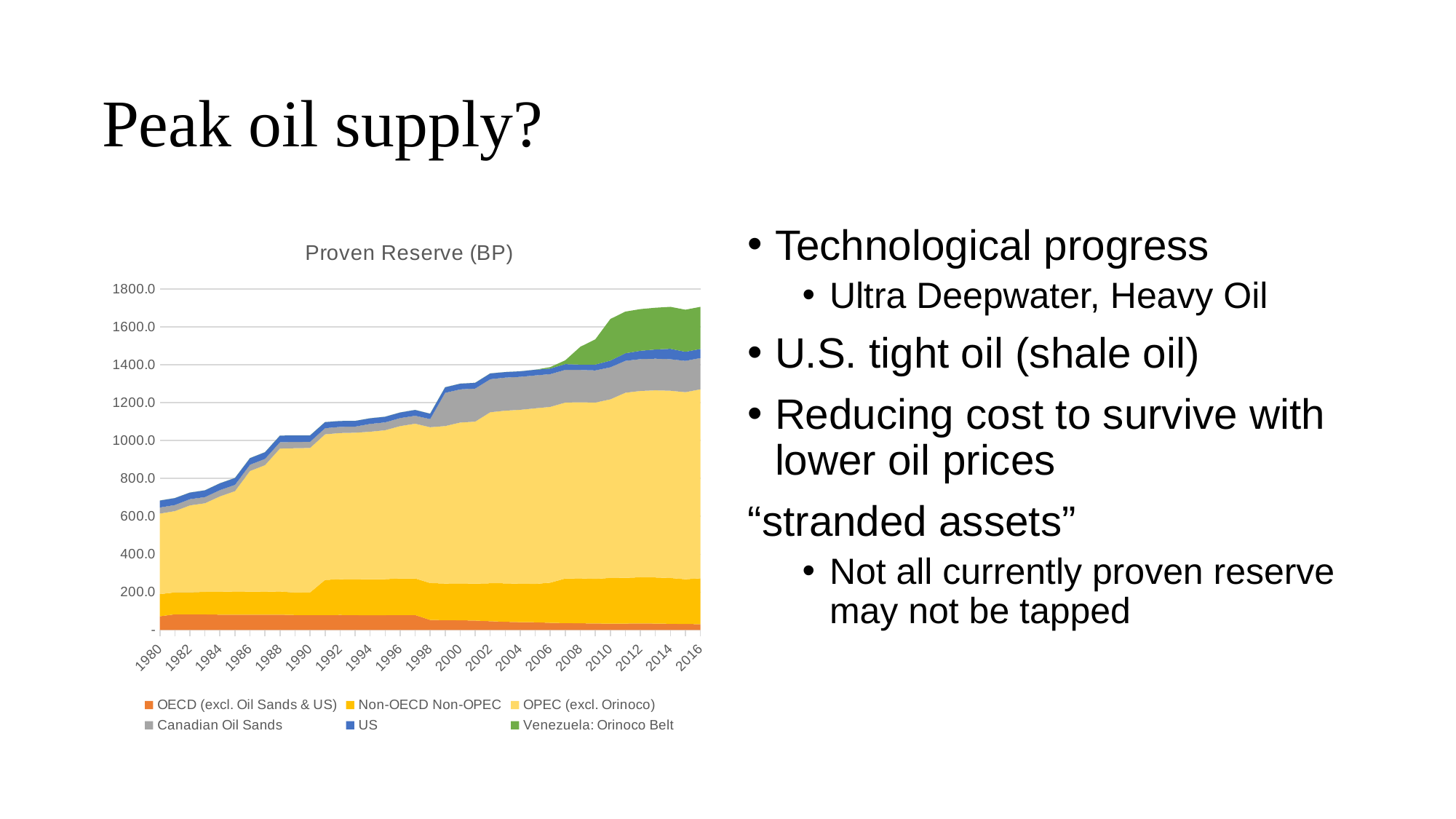
How many year labels are shown on the x axis? 19 Is the total proven reserve in 2016 greater or less than 1600.0? greater How many series does the chart's legend list? 6 Which series accounts for the largest share of the proven reserve throughout the chart? OPEC (excl. Orinoco) Is the total proven reserve larger in 2016 or in 1980? 2016 Which series is shown in green in the chart? Venezuela: Orinoco Belt Is the total proven reserve in 1996 greater or less than 1000.0? greater Does the total proven reserve rise or fall from 1980 to 2016? Rise What is the title of the chart? Proven Reserve (BP) Is the total proven reserve in 2000 greater or less than 1200.0? greater What kind of chart is shown on the slide? Stacked area chart